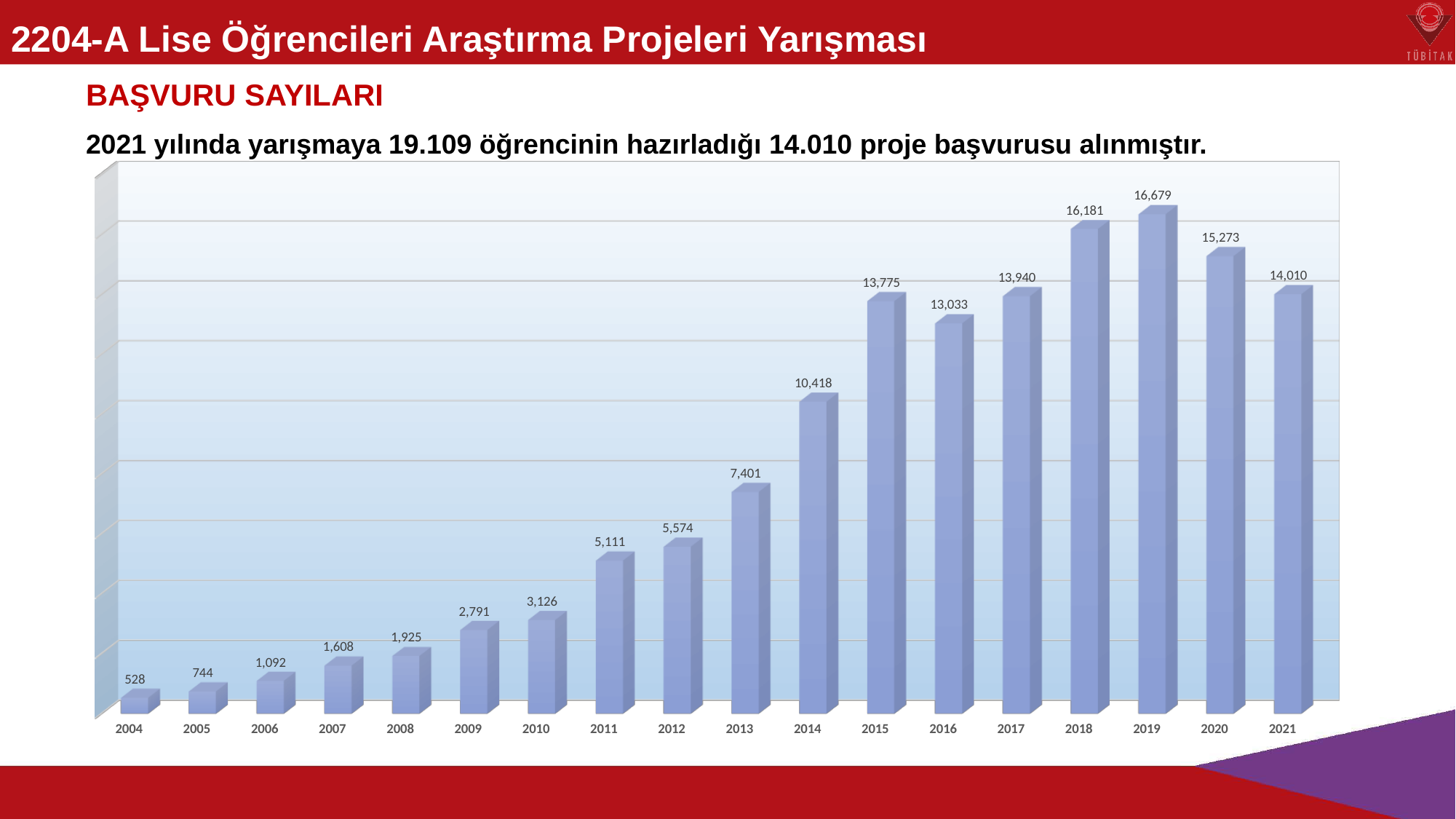
Do the values generally rise or fall from 2004 to 2019? rise What is the difference between the values for 2019 and 2018? 498 Which year has the lowest value in the chart? 2004 Which year has the highest value in the chart? 2019 What is the value shown for 2021? 14,010 What is the heading shown in red above the chart? BAŞVURU SAYILARI What type of chart is shown on the slide? bar chart How many years (categories) are shown on the x axis of the chart? 18 What is the value shown for 2004? 528 Which year has the larger value, 2015 or 2016? 2015 What is the difference between the values for 2020 and 2021? 1,263 What is the value shown for 2014? 10,418